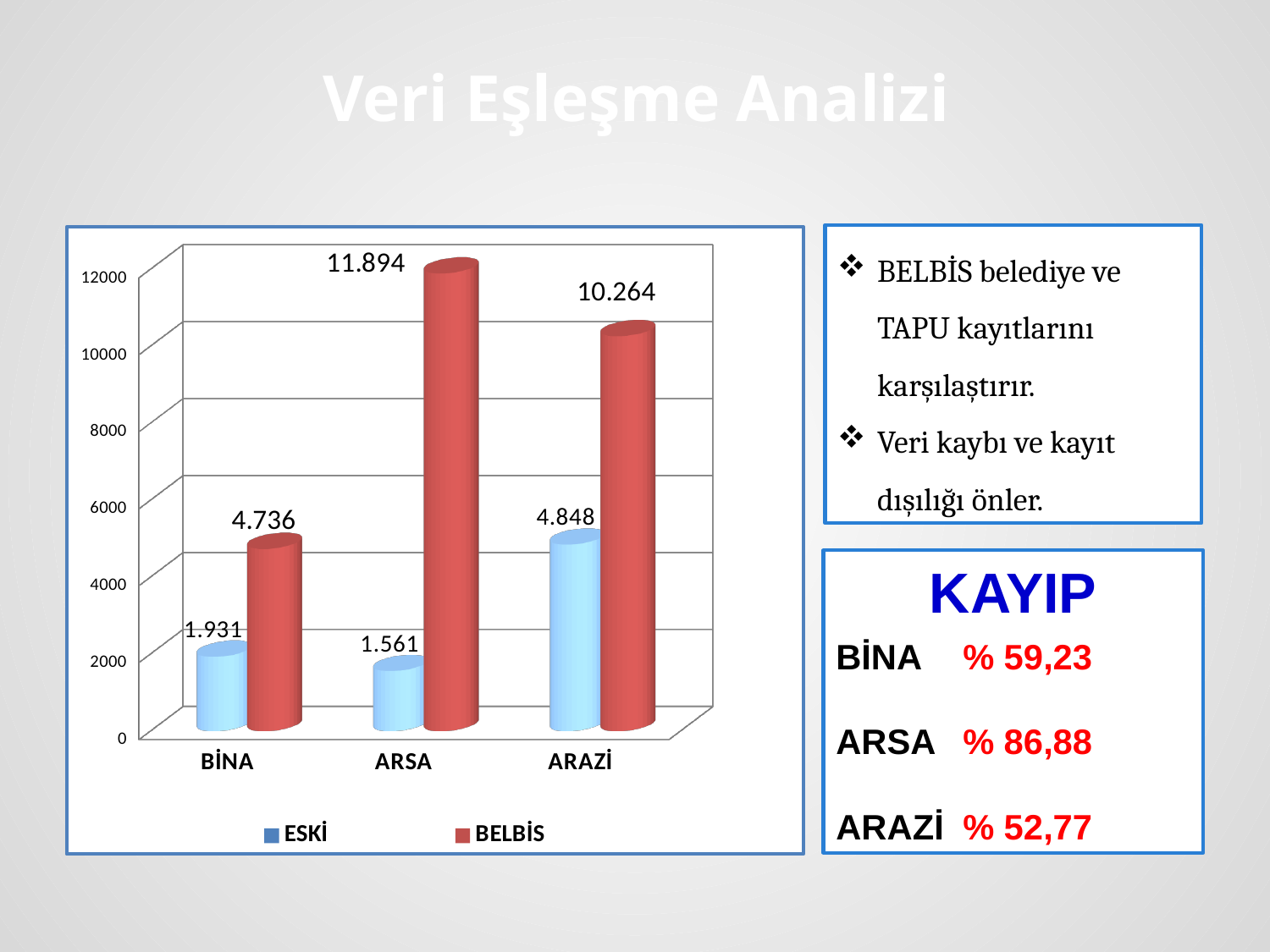
How many series does the legend list? 2 How many categories are shown on the x axis? 3 What is the difference between the BELBİS and ESKİ values for ARSA? 10.333 What is the ESKİ value for BİNA? 1.931 What kind of chart is shown on the slide? Bar chart What is the ESKİ value for ARAZİ? 4.848 What is the difference between the BELBİS and ESKİ values for BİNA? 2.805 What is the BELBİS value for ARSA? 11.894 Which category has the lowest ESKİ value? ARSA Which category has the highest BELBİS value? ARSA Which is larger, the ESKİ value for ARAZİ or the BELBİS value for BİNA? ESKİ value for ARAZİ What is the BELBİS value for ARAZİ? 10.264